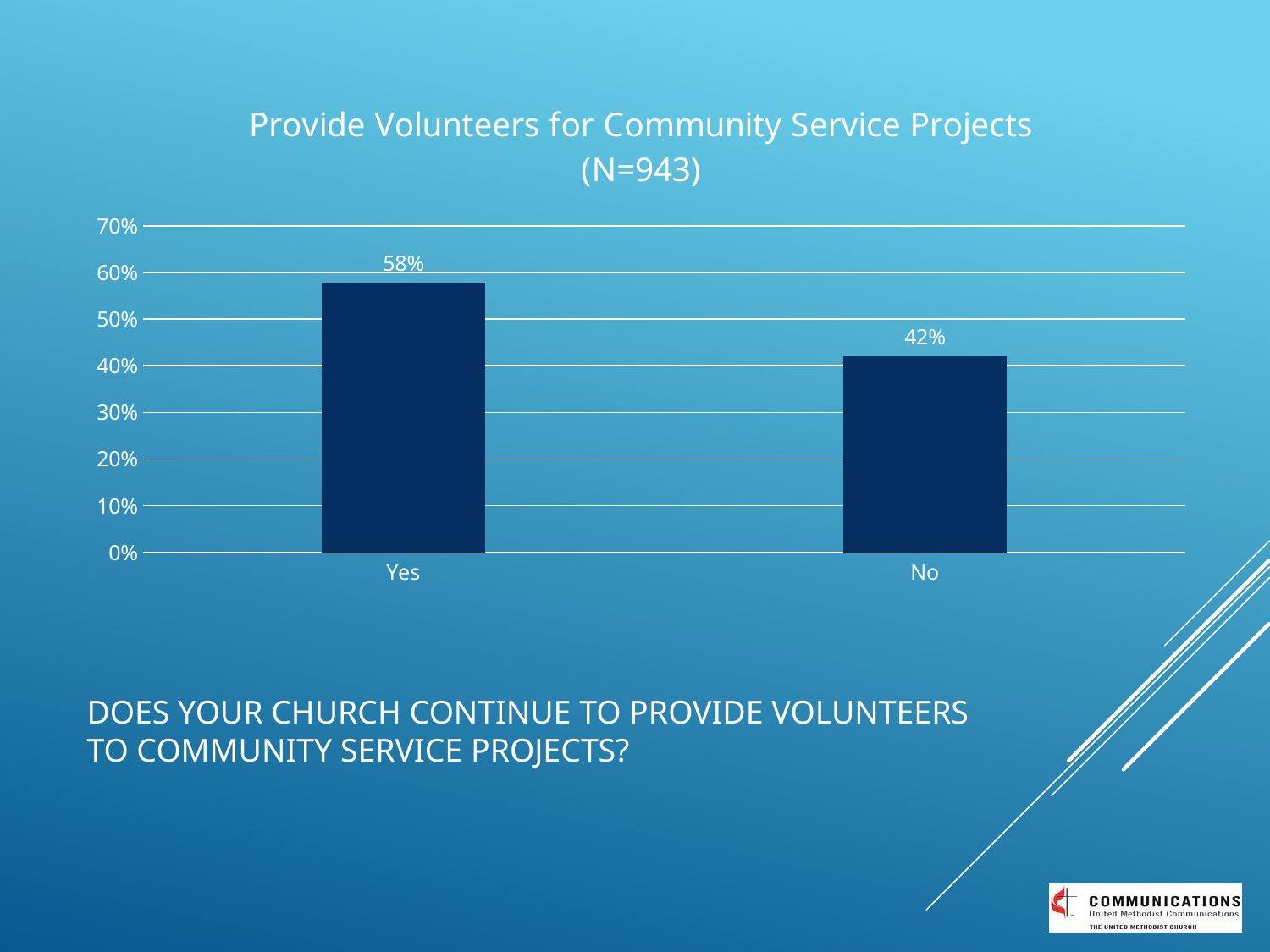
What is the difference between the Yes and No percentages? 16% Is the value for Yes greater or less than 50%? greater Is the value for No greater or less than 50%? less Which category has the highest value? Yes How many categories are shown on the x axis? 2 What percentage of respondents answered Yes? 58% What percentage of respondents answered No? 42% Which is larger, the value for Yes or the value for No? Yes What is the highest value shown on the y axis? 70% What is the title of the chart? Provide Volunteers for Community Service Projects (N=943) What kind of chart is shown on the slide? bar chart Which category has the lowest value? No